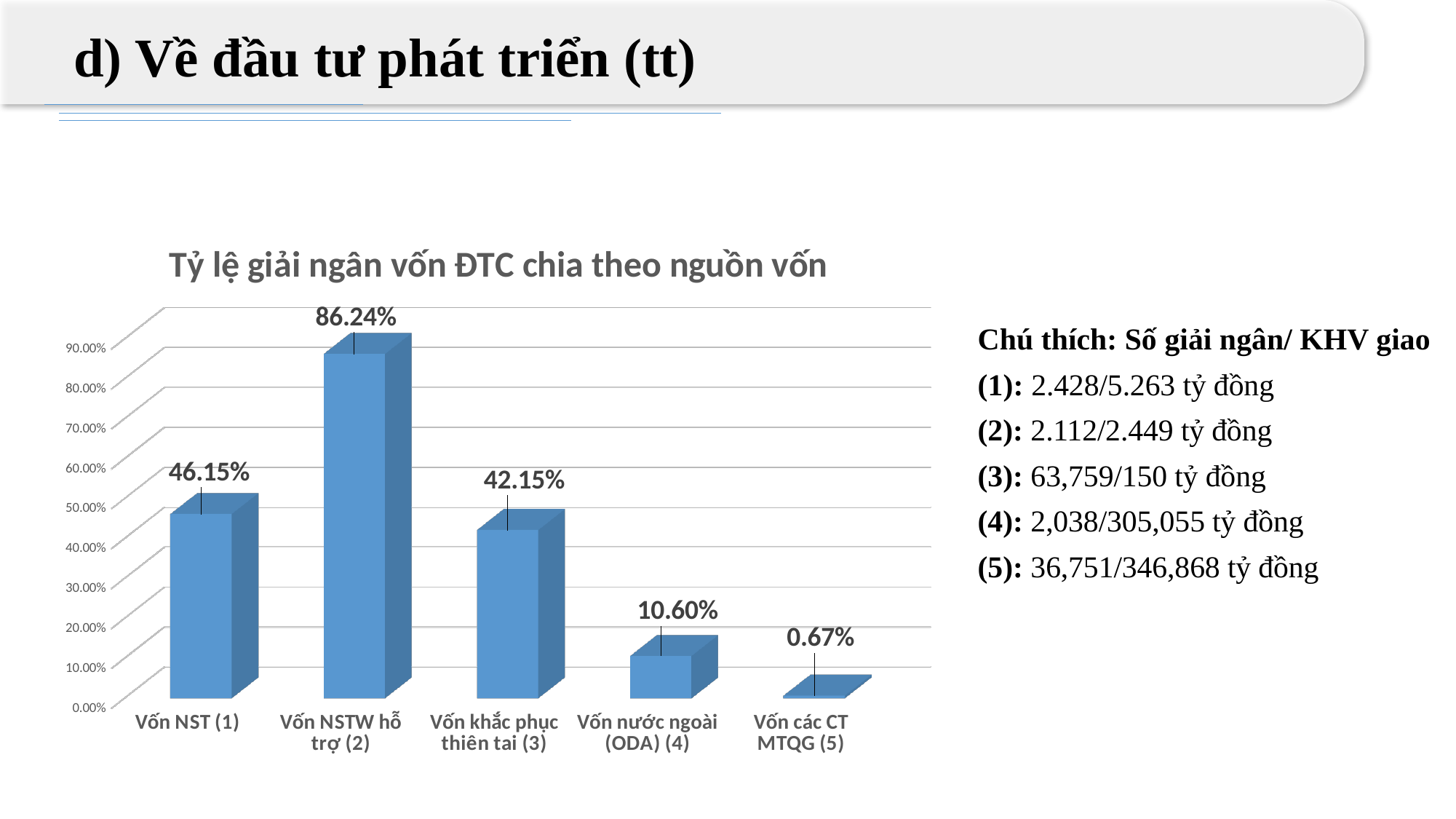
What is the disbursement rate for Vốn NST (1)? 46.15% Which is larger, the value for Vốn khắc phục thiên tai (3) or Vốn nước ngoài (ODA) (4)? Vốn khắc phục thiên tai (3) What is the value shown for Vốn các CT MTQG (5)? 0.67% What kind of chart is shown on the slide? Bar chart What is the value shown for Vốn nước ngoài (ODA) (4)? 10.60% Which funding source has the highest disbursement rate? Vốn NSTW hỗ trợ (2) What is the value shown for Vốn NSTW hỗ trợ (2)? 86.24% What is the title of the chart? Tỷ lệ giải ngân vốn ĐTC chia theo nguồn vốn What is the difference between the values for Vốn NST (1) and Vốn khắc phục thiên tai (3)? 4.00% How many funding source categories are shown in the chart? 5 Which funding source has the lowest disbursement rate? Vốn các CT MTQG (5) What is the difference between the values for Vốn NSTW hỗ trợ (2) and Vốn NST (1)? 40.09%